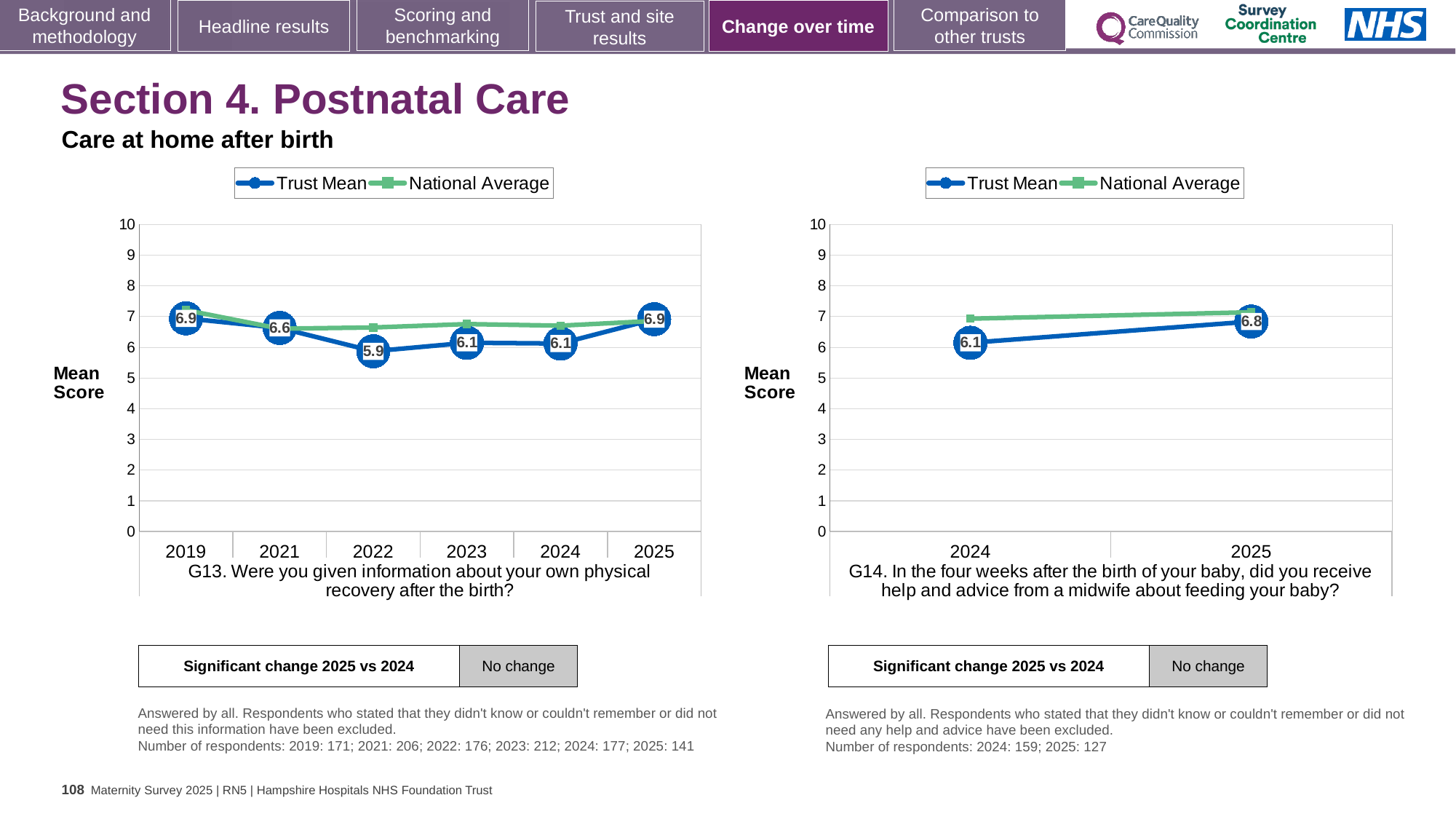
How many series does the legend of the right chart (G14) list? 2 In the right chart (G14), does the Trust Mean rise or fall from 2024 to 2025? Rise In the right chart (G14), what is the Trust Mean for 2024? 6.1 In the right chart (G14), what is the difference between the Trust Mean for 2025 and 2024? 0.7 How many years are plotted on the x axis of the left chart (G13)? 6 In the left chart (G13), which year has the lowest Trust Mean? 2022 In the left chart (G13), is the Trust Mean higher in 2021 or in 2023? 2021 In the right chart (G14), is the National Average for 2024 greater or less than 6? greater In the left chart (G13), what is the difference between the Trust Mean for 2019 and 2022? 1.0 In the left chart (G13), what is the Trust Mean for 2022? 5.9 What kind of chart is the right chart (G14)? Line chart In the left chart (G13), what is the Trust Mean for 2025? 6.9